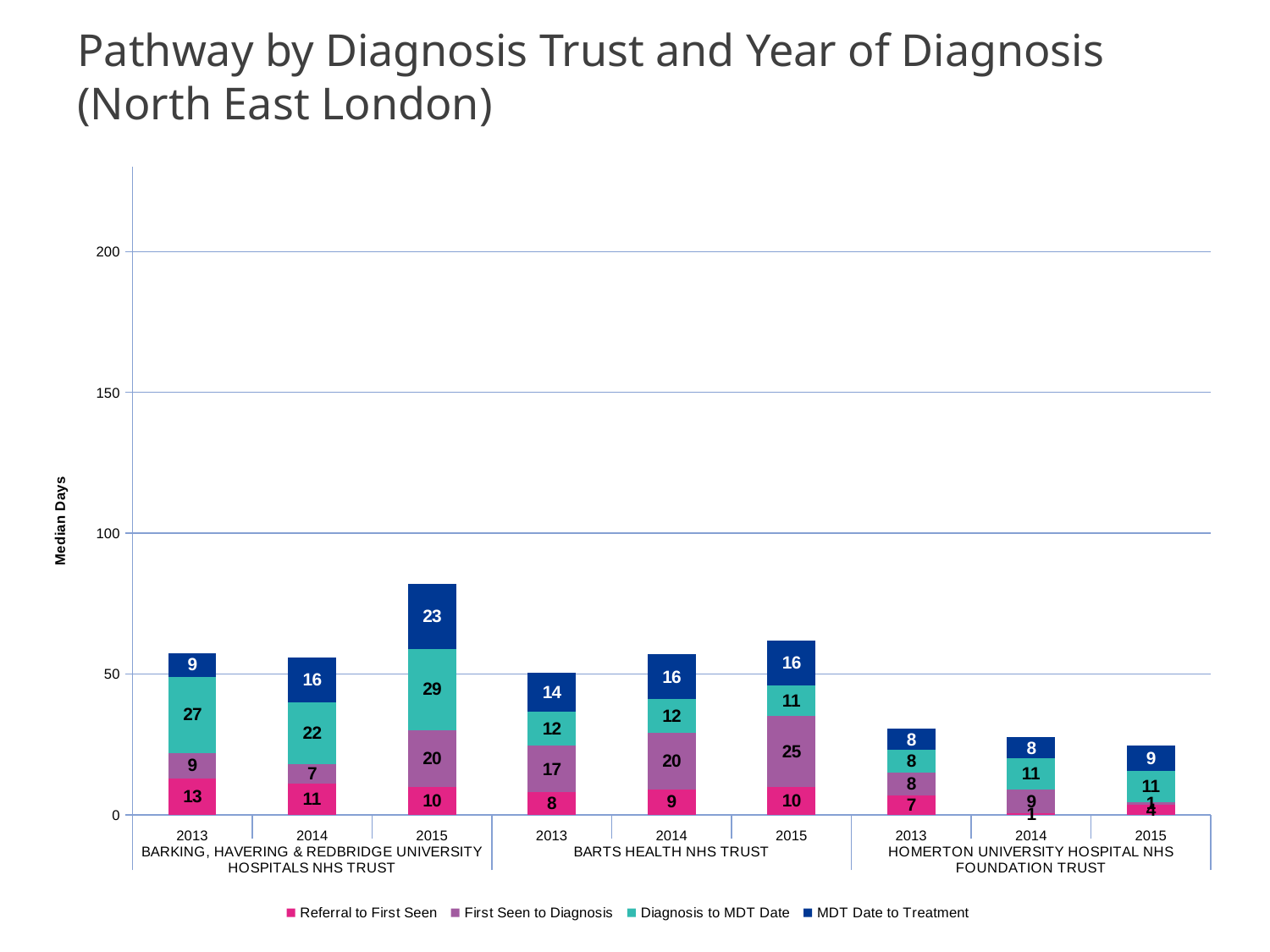
What is the difference between the Diagnosis to MDT Date value for Barking, Havering & Redbridge in 2015 and for Barts Health in 2015? 18 What is the value of Diagnosis to MDT Date for Barking, Havering & Redbridge University Hospitals NHS Trust in 2013? 27 Is the total for Homerton University Hospital NHS Foundation Trust in 2013 greater or less than 50? less What is the total of the stacked bar for Barts Health NHS Trust in 2013? 51 What is the total of the stacked bar for Barking, Havering & Redbridge University Hospitals NHS Trust in 2015? 82 How many stacked bars are plotted on the chart? 9 What kind of chart is shown on the slide? Stacked bar chart What is the value of First Seen to Diagnosis for Barts Health NHS Trust in 2015? 25 How many series does the legend list? 4 Which is larger: First Seen to Diagnosis for Barts Health NHS Trust in 2014 or for Barking, Havering & Redbridge in 2014? Barts Health NHS Trust in 2014 Which trust and year has the tallest stacked bar? Barking, Havering & Redbridge University Hospitals NHS Trust, 2015 What is the value of MDT Date to Treatment for Barking, Havering & Redbridge University Hospitals NHS Trust in 2015? 23